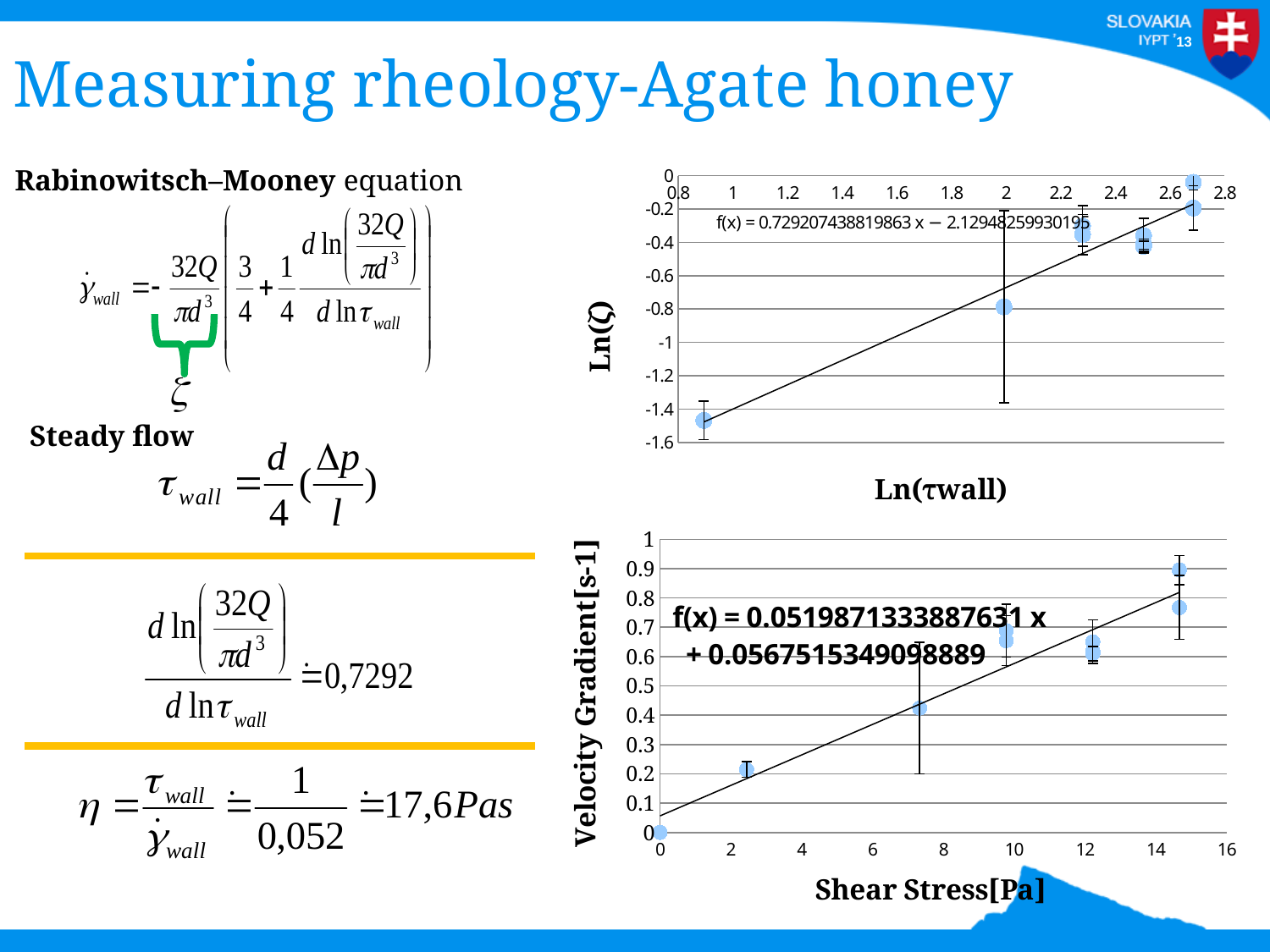
In the top chart, what is the y-axis label? Ln(ζ) In the bottom chart, do the velocity gradient values rise or fall as shear stress increases? rise In the bottom chart, what is the trendline equation printed on the chart? f(x) = 0.0519871333887631 x + 0.0567515349098889 In the top chart, what is the trendline equation printed on the chart? f(x) = 0.729207438819863 x − 2.12948259930195 What kind of chart is the bottom chart (Velocity Gradient vs Shear Stress)? scatter chart In the top chart, is the Ln(ζ) value of the leftmost point greater or less than -1? less In the top chart, what is the intercept of the fitted line f(x)? −2.12948259930195 In the top chart, do the Ln(ζ) values rise or fall as Ln(τwall) increases? rise In the bottom chart, what is the slope of the fitted line f(x)? 0.0519871333887631 In the bottom chart, is the velocity gradient of the points at the highest shear stress (rightmost cluster) greater or less than 0.5? greater In the bottom chart, what is the x-axis label? Shear Stress[Pa] What kind of chart is the top chart (Ln(ζ) vs Ln(τwall))? scatter chart